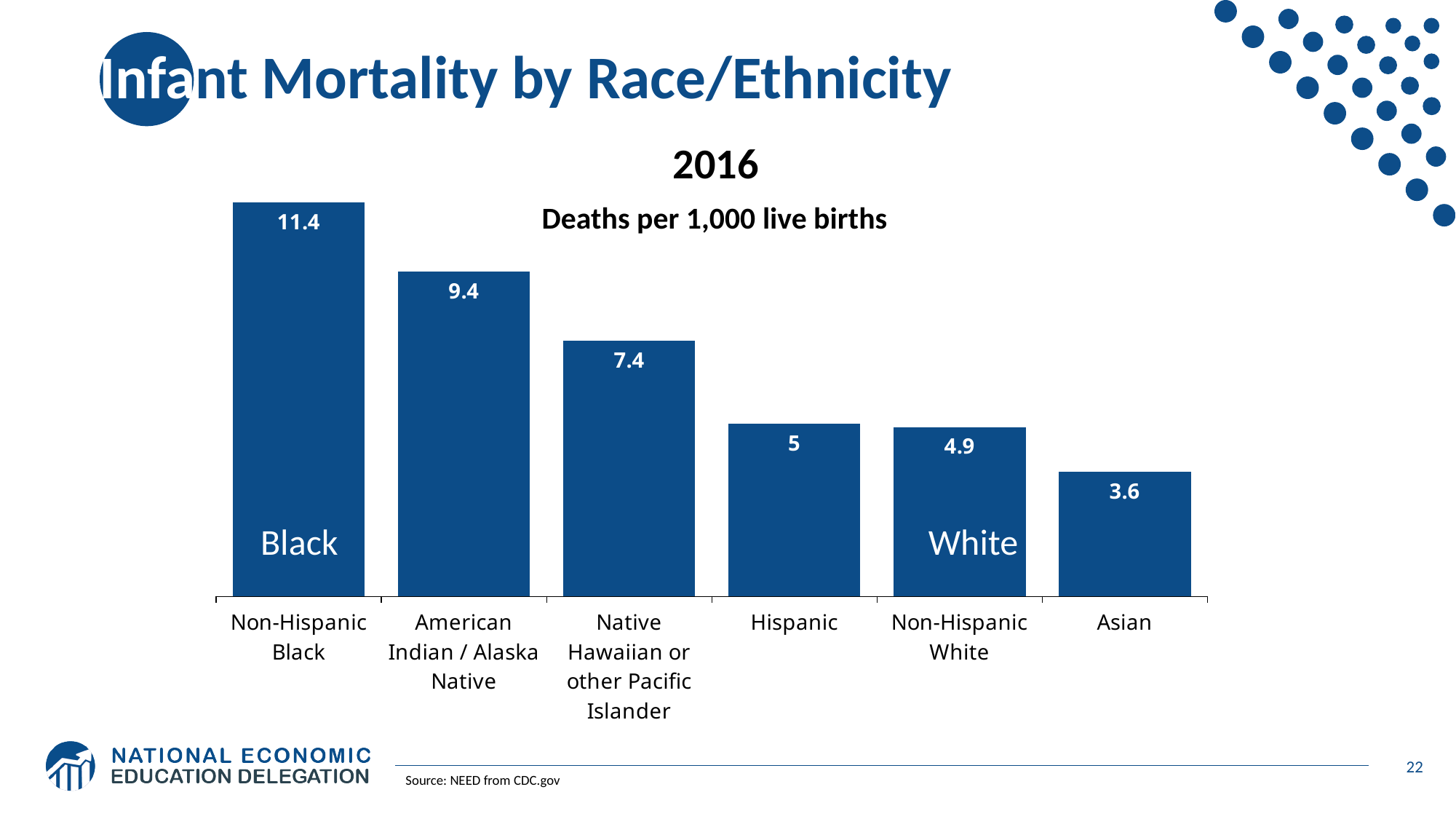
What is the value shown for Hispanic? 5 How many race/ethnicity categories are shown in the chart? 6 What kind of chart is shown on the slide? Bar chart What is the infant mortality rate for Non-Hispanic Black in 2016? 11.4 Which category has the lowest infant mortality rate? Asian What is the value shown for American Indian / Alaska Native? 9.4 What unit is the chart measured in, according to the subtitle? Deaths per 1,000 live births Which category has the highest infant mortality rate? Non-Hispanic Black What is the value shown for Asian? 3.6 What is the difference between the Non-Hispanic Black and Non-Hispanic White values? 6.5 Which is larger, the value for Hispanic or the value for Non-Hispanic White? Hispanic What is the value shown for Native Hawaiian or other Pacific Islander? 7.4